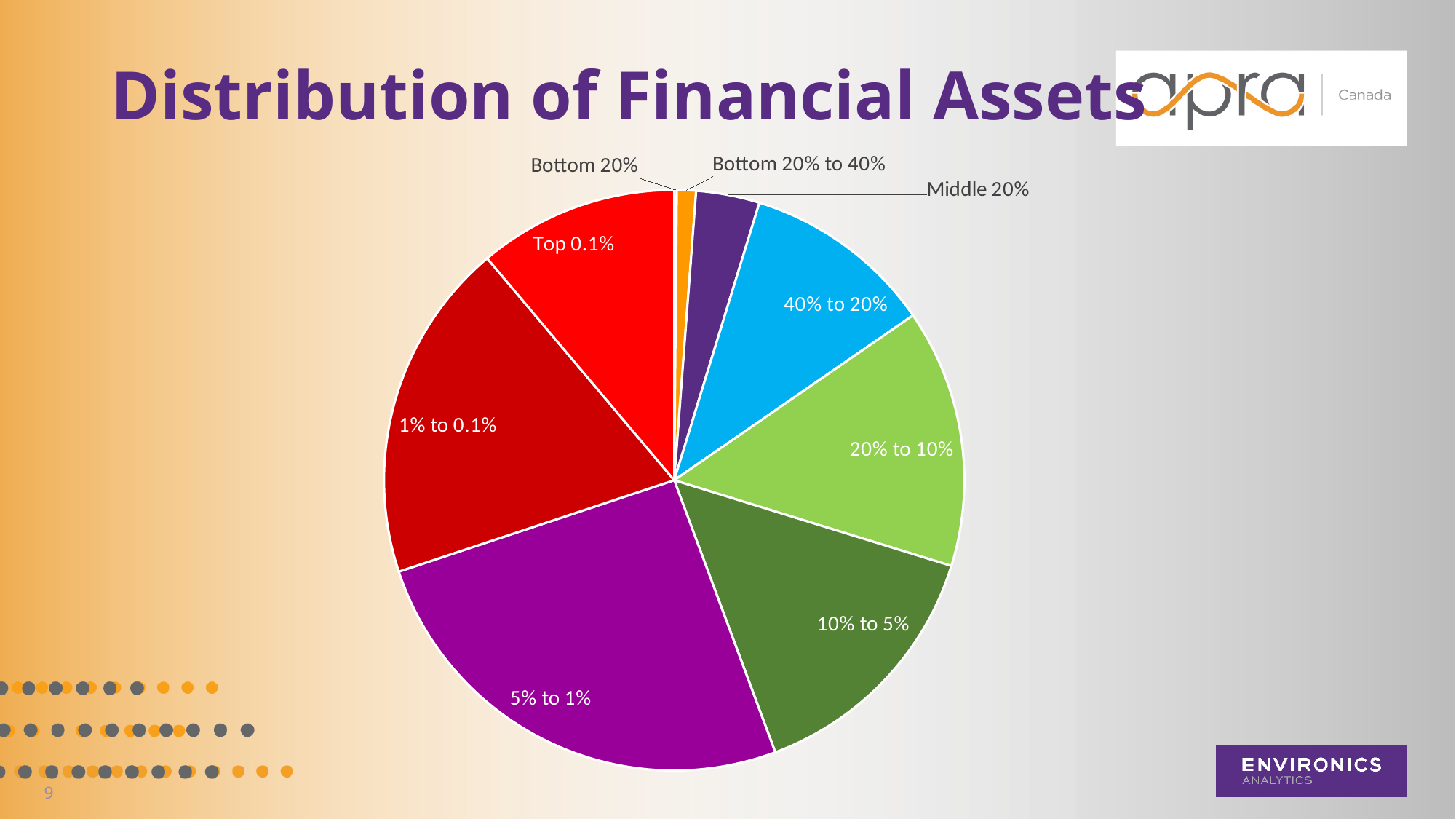
Which slice is larger: 1% to 0.1% or Top 0.1%? 1% to 0.1% Which slice is larger: 5% to 1% or 10% to 5%? 5% to 1% How many slices does the pie chart have? 9 What colour is the 5% to 1% slice? Purple What kind of chart is shown on the slide? Pie chart Which slice is larger: Bottom 20% to 40% or Bottom 20%? Bottom 20% to 40% Which category has the smallest slice of the pie chart? Bottom 20% Which category has the largest slice of the pie chart? 5% to 1% What is the title of the slide? Distribution of Financial Assets